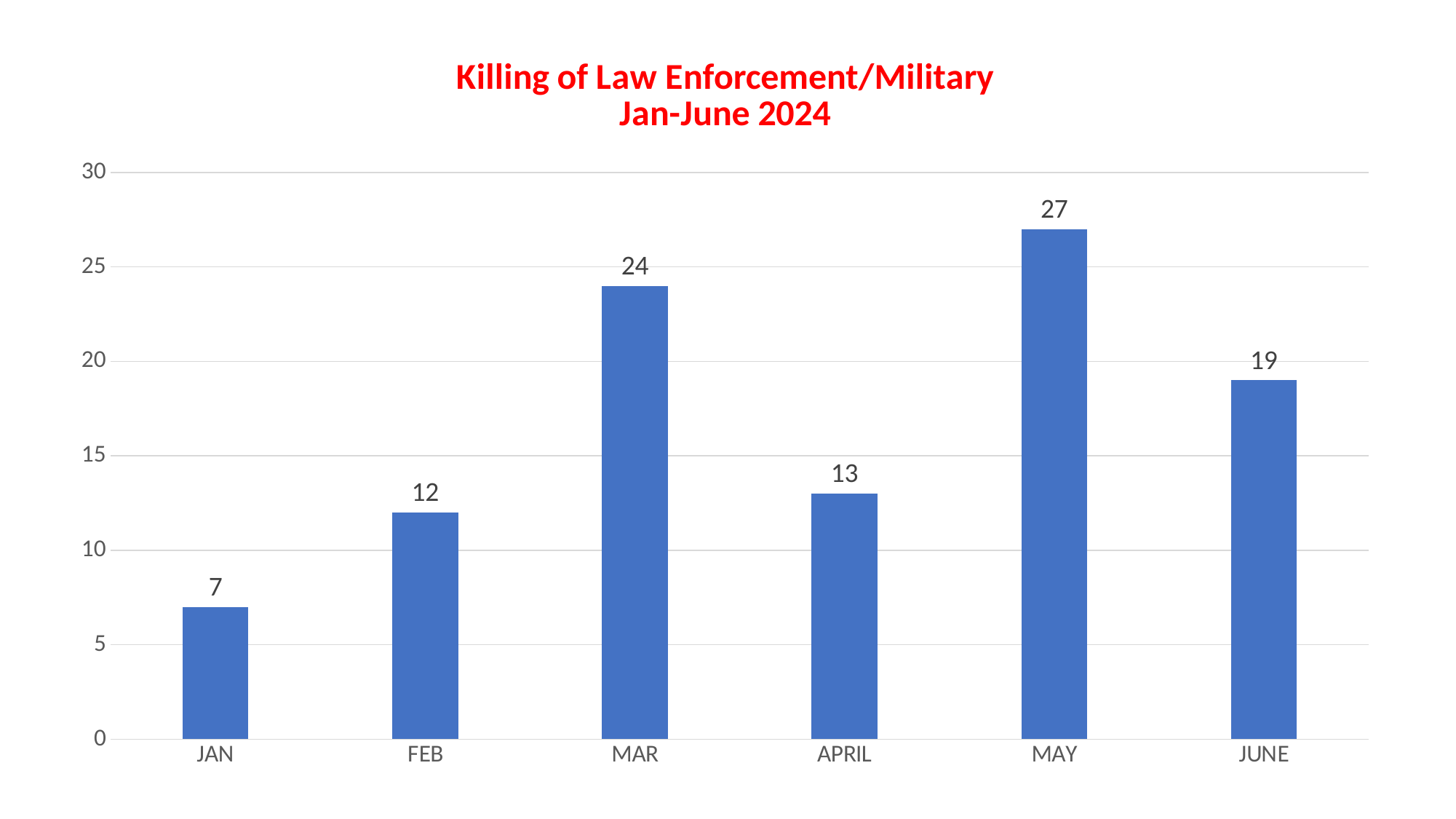
What is the difference between the values for MAR and FEB? 12 What is the title of the chart? Killing of Law Enforcement/Military Jan-June 2024 How many months are shown on the x axis? 6 Which is larger, the value for JUNE or the value for APRIL? JUNE What is the difference between the values for MAY and APRIL? 14 Which month has the highest value? MAY What is the value for JUNE? 19 What is the value for JAN? 7 Is the value for FEB greater or less than 10? greater Which month has the lowest value? JAN What kind of chart is this? bar chart What is the value for MAR? 24